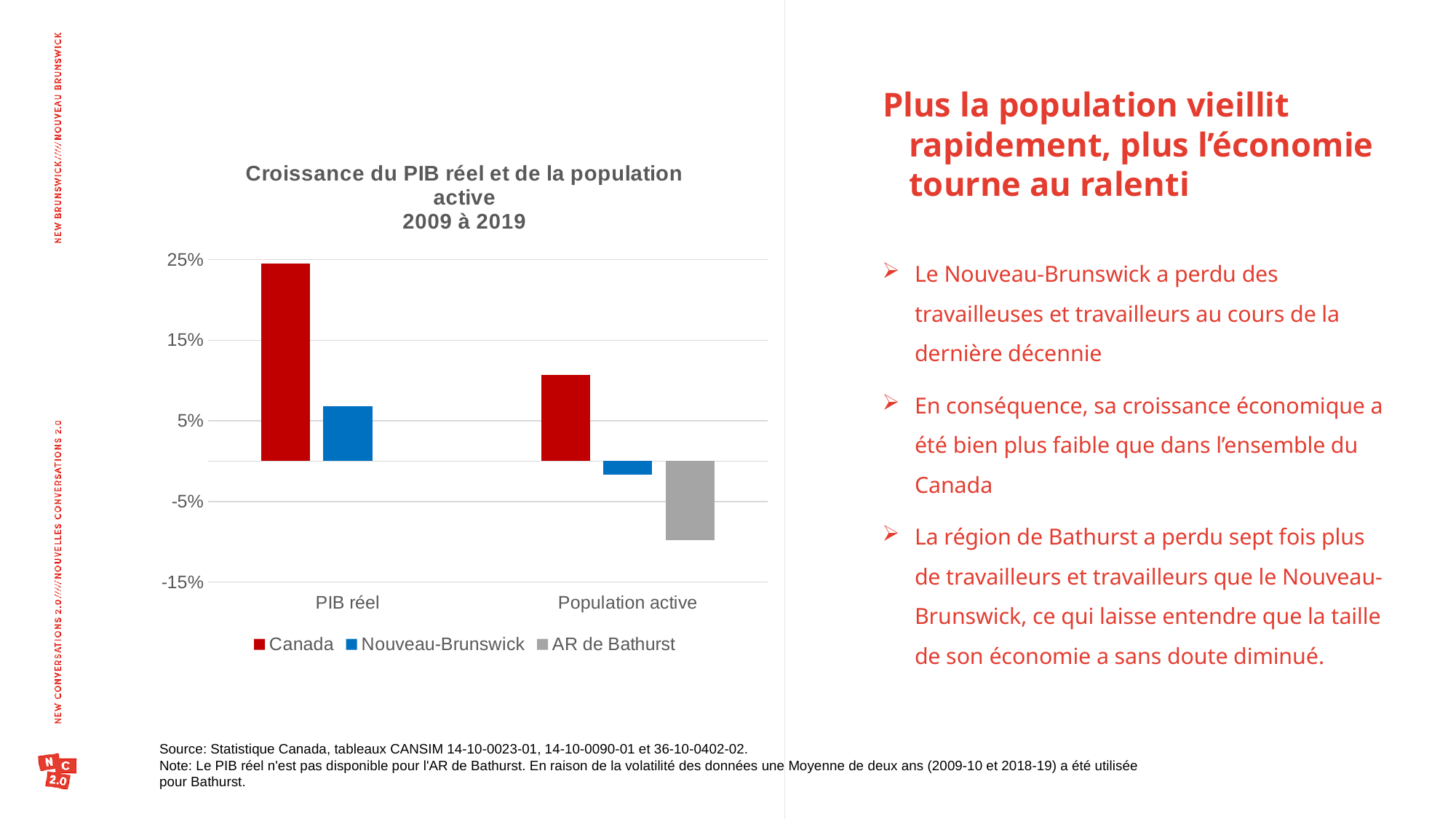
Which series has the highest value for PIB réel? Canada How many series does the legend list? 3 Is the value for AR de Bathurst in Population active greater or less than -5%? less Is the value for Nouveau-Brunswick in Population active greater or less than 5%? less Which series has the lowest value for Population active? AR de Bathurst Is the value for Canada in PIB réel greater or less than 15%? greater For Canada, which is larger: the value for PIB réel or the value for Population active? PIB réel Which series is shown in grey in the legend? AR de Bathurst How many categories are shown on the x axis? 2 What is the title of the chart? Croissance du PIB réel et de la population active 2009 à 2019 What kind of chart is shown on the slide? bar chart